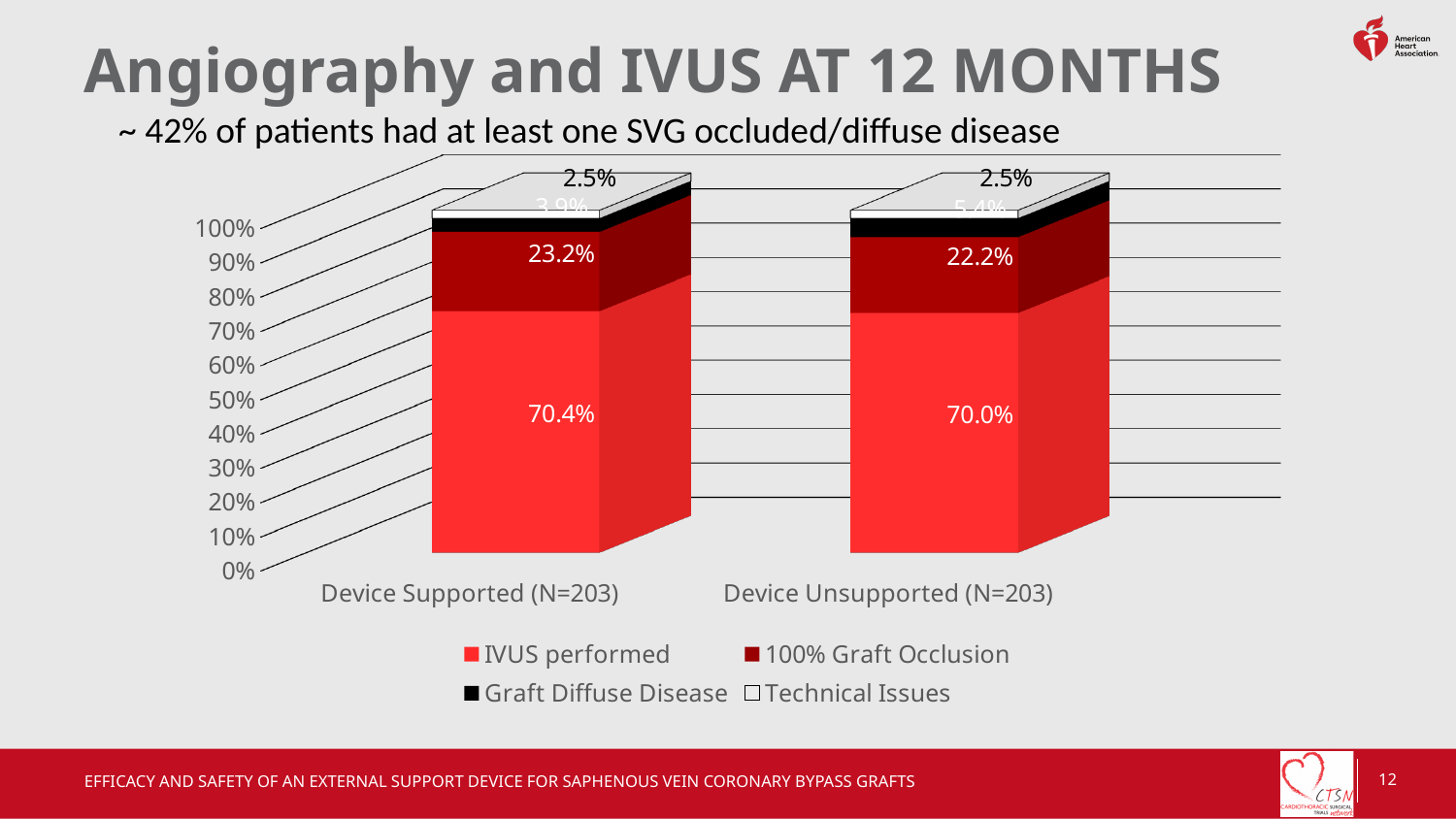
Which category has the larger 100% Graft Occlusion value, Device Supported or Device Unsupported? Device Supported (N=203) What is the value of 100% Graft Occlusion for Device Supported (N=203)? 23.2% How many categories are shown on the x axis of the chart? 2 What is the value of 100% Graft Occlusion for Device Unsupported (N=203)? 22.2% What kind of chart is shown on the slide? Stacked bar chart What is the value of IVUS performed for Device Supported (N=203)? 70.4% What is the value of IVUS performed for Device Unsupported (N=203)? 70.0% What is the difference between the 100% Graft Occlusion values for Device Supported and Device Unsupported? 1.0 percentage points What is the value of Technical Issues for Device Unsupported (N=203)? 2.5% How many series does the chart legend list? 4 What is the value of Technical Issues for Device Supported (N=203)? 2.5% What is the difference between the IVUS performed values for Device Supported and Device Unsupported? 0.4 percentage points